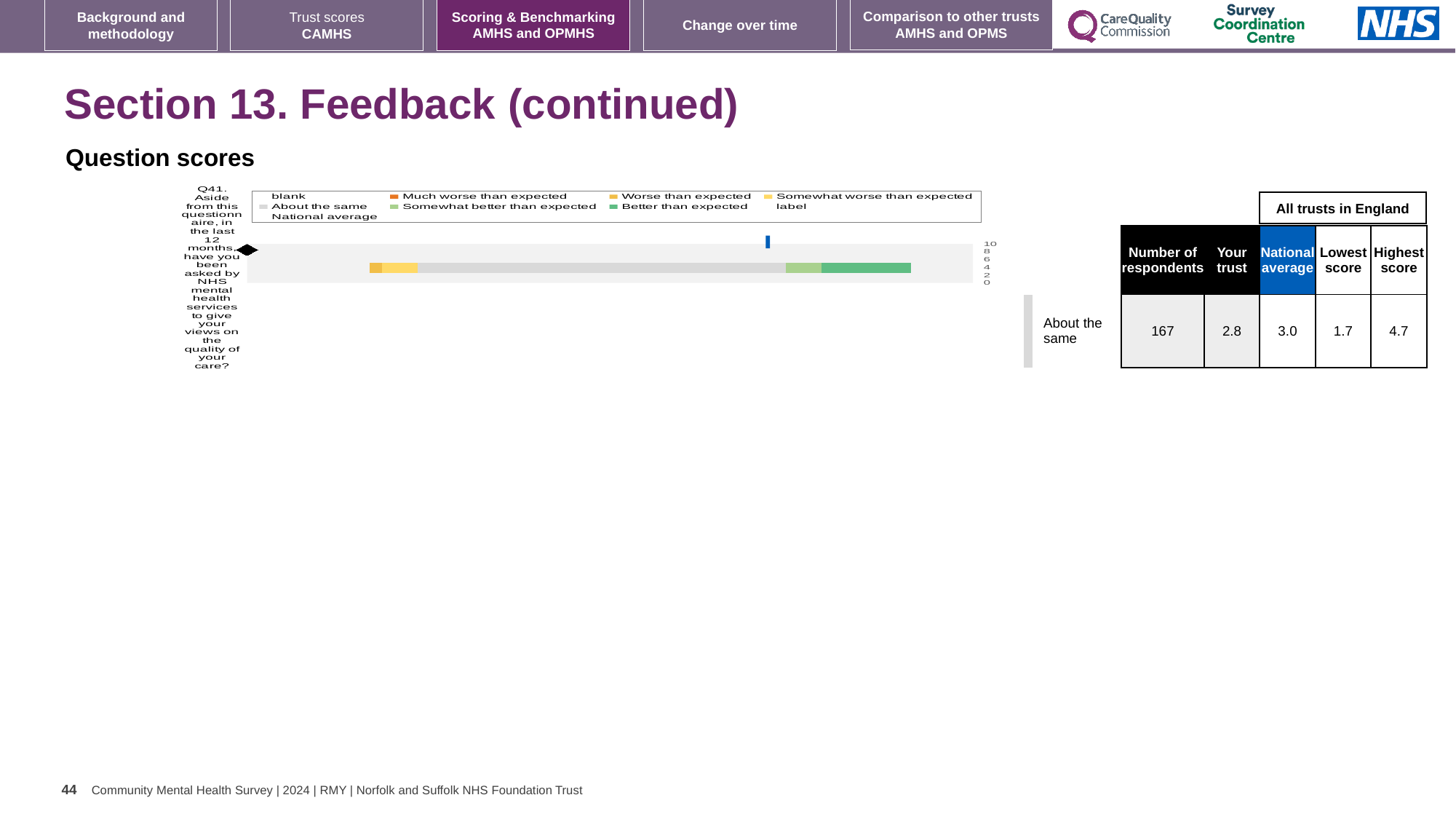
What kind of chart is shown for Q41 on the slide? bar chart Which legend entry is shown in dark orange? Much worse than expected In the table beside the chart, what is the national average for Q41? 3.0 In the table beside the chart, what is the 'Your trust' score for Q41? 2.8 Which legend entry is shown in grey? About the same How many entries does the chart's legend list? 9 In the table beside the chart, what is the highest score among all trusts in England for Q41? 4.7 How many questions (categories) are plotted in the chart? 1 In the table beside the chart, what is the number of respondents for Q41? 167 Which benchmark category is Q41 assigned to on the slide? About the same What is the difference between the highest score and the lowest score for Q41 in the table? 3.0 Which is larger for Q41: the 'Your trust' score or the national average? National average